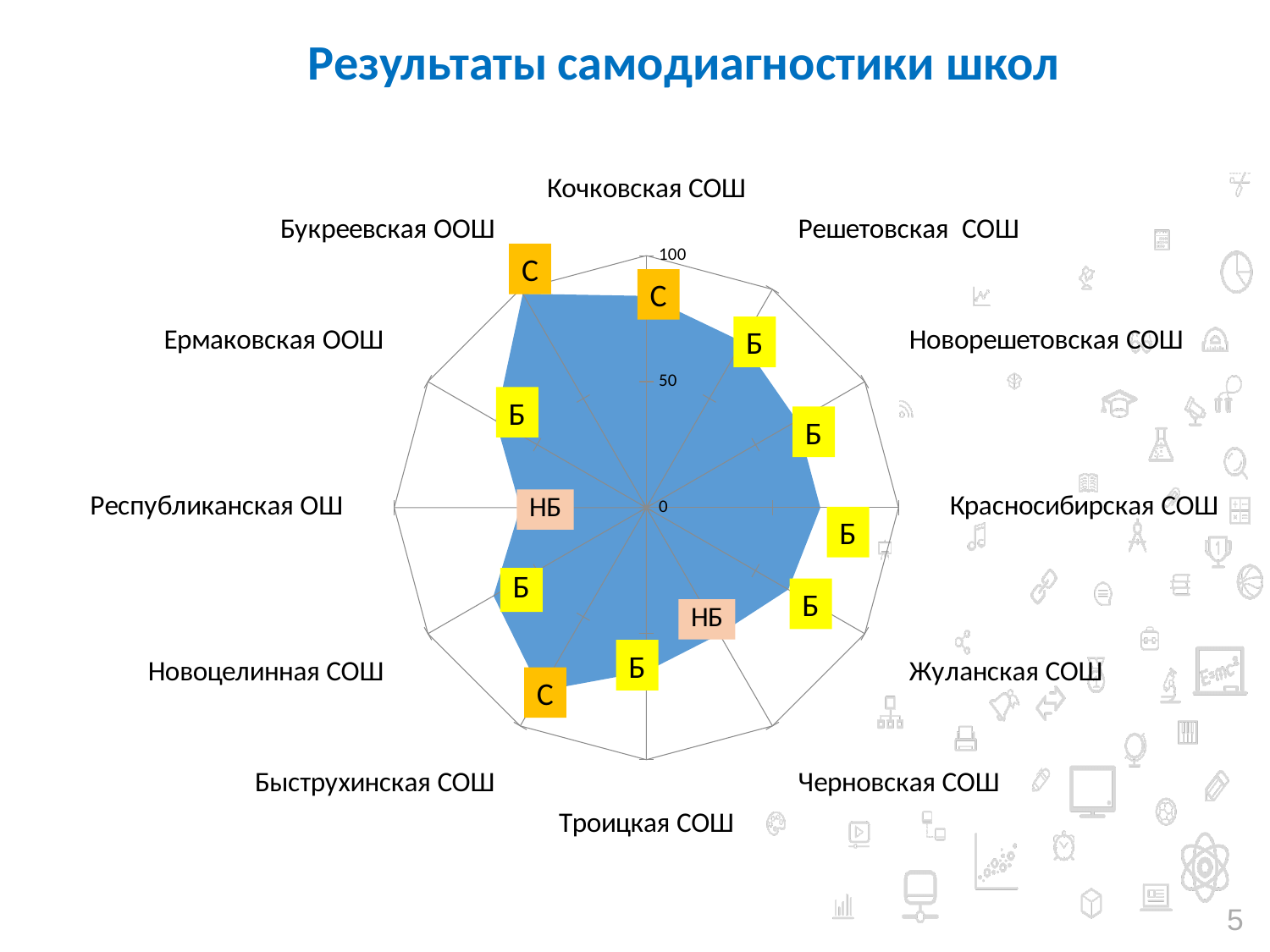
How many schools (categories) are plotted on the radar chart? 12 What is the title of the slide with the radar chart? Результаты самодиагностики школ Which is larger, the value for Букреевская ООШ or the value for Ермаковская ООШ? Букреевская ООШ Is the value for Быструхинская СОШ greater or less than 50? greater Is the value for Красносибирская СОШ greater or less than 50? greater What is the maximum value shown on the radar chart's axis scale? 100 What kind of chart is shown on the slide? radar chart Which is larger, the value for Кочковская СОШ or the value for Республиканская ОШ? Кочковская СОШ Is the value for Букреевская ООШ greater or less than 50? greater Which school has the lowest value on the radar chart? Республиканская ОШ